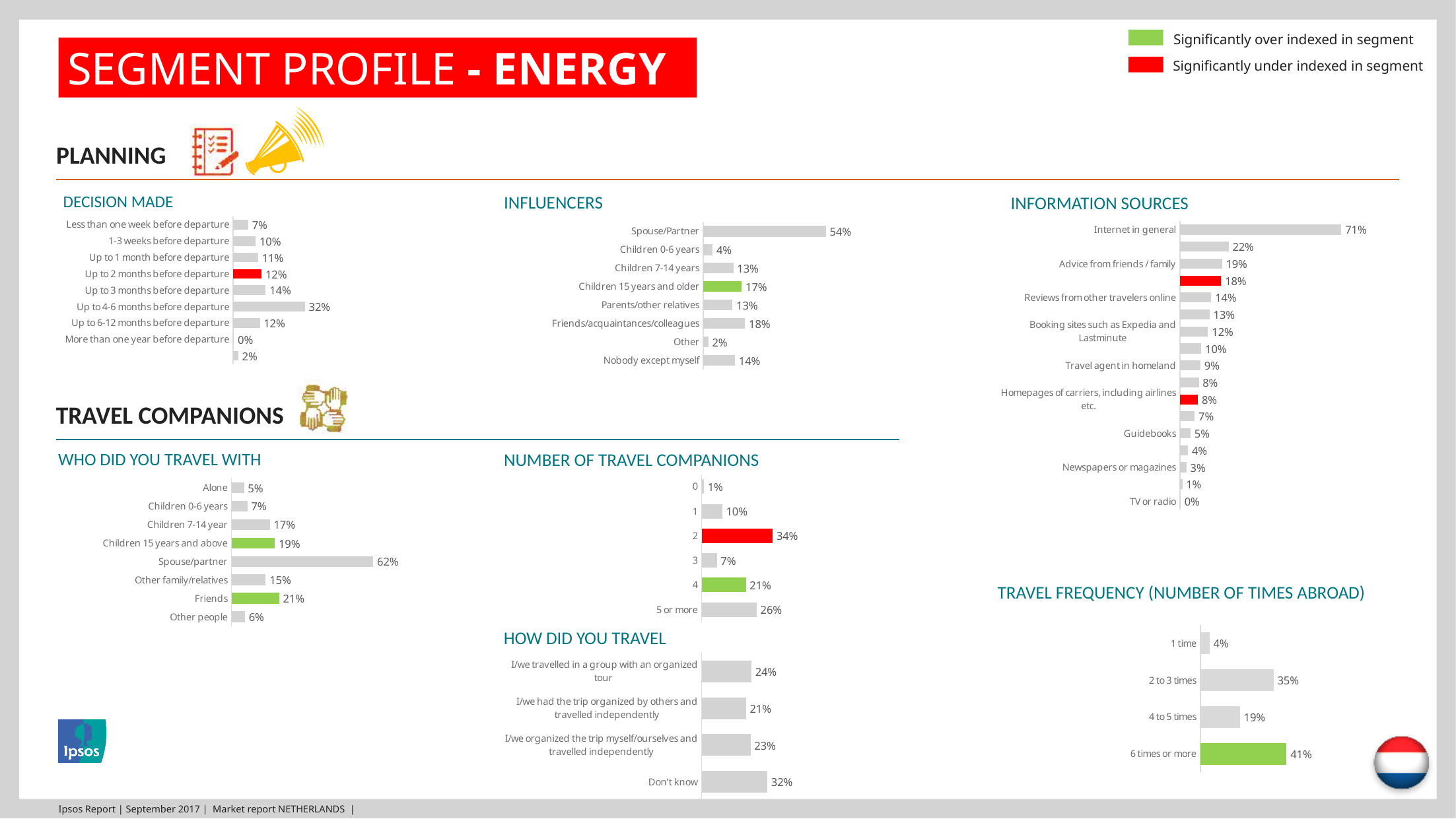
In the TRAVEL FREQUENCY (NUMBER OF TIMES ABROAD) chart, which category has the highest value? 6 times or more In the INFORMATION SOURCES chart, which category has the lowest value? TV or radio In the INFORMATION SOURCES chart, what is the value for 'Internet in general'? 71% In the WHO DID YOU TRAVEL WITH chart, what is the difference between 'Spouse/partner' and 'Friends'? 41% In the INFLUENCERS chart, what is the value for 'Friends/acquaintances/colleagues'? 18% In the INFLUENCERS chart, which category has the highest value? Spouse/Partner In the WHO DID YOU TRAVEL WITH chart, how many categories are shown? 8 In the DECISION MADE chart, what is the value for 'Up to 4-6 months before departure'? 32% In the HOW DID YOU TRAVEL chart, what is the value for 'Don't know'? 32% In the NUMBER OF TRAVEL COMPANIONS chart, which is larger: the value for '2' or the value for '5 or more'? 2 What type of chart is the TRAVEL FREQUENCY (NUMBER OF TIMES ABROAD) chart? Bar chart In the NUMBER OF TRAVEL COMPANIONS chart, what is the value for '4'? 21%